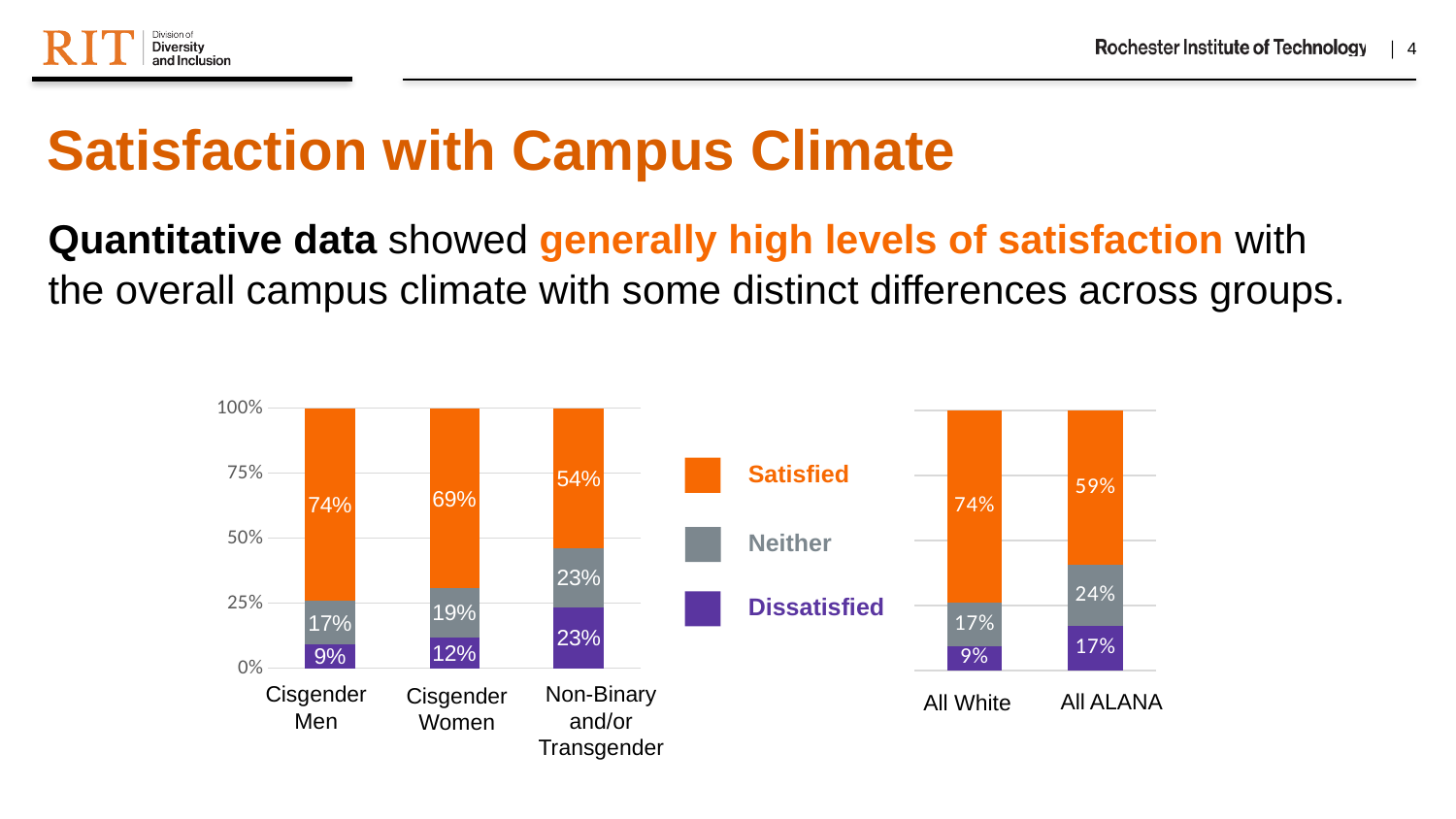
In the left chart, which is larger: the Dissatisfied percentage for Cisgender Women or for Cisgender Men? Cisgender Women Which colour represents the Dissatisfied series in the legend? Purple What kind of chart is the right chart? Stacked bar chart In the right chart, what percentage of All ALANA respondents are Neither satisfied nor dissatisfied? 24% In the left chart, which group has the lowest Satisfied percentage? Non-Binary and/or Transgender How many groups are shown on the x axis of the left chart? 3 How many series does the legend list? 3 In the left chart, which group has the highest Dissatisfied percentage? Non-Binary and/or Transgender In the left chart, what percentage of Non-Binary and/or Transgender respondents are Dissatisfied? 23% In the right chart, what is the difference between the Satisfied percentages for All White and All ALANA? 15% In the right chart, is the Satisfied percentage for All ALANA greater or less than 50%? greater In the left chart, what percentage of Cisgender Men are Satisfied? 74%